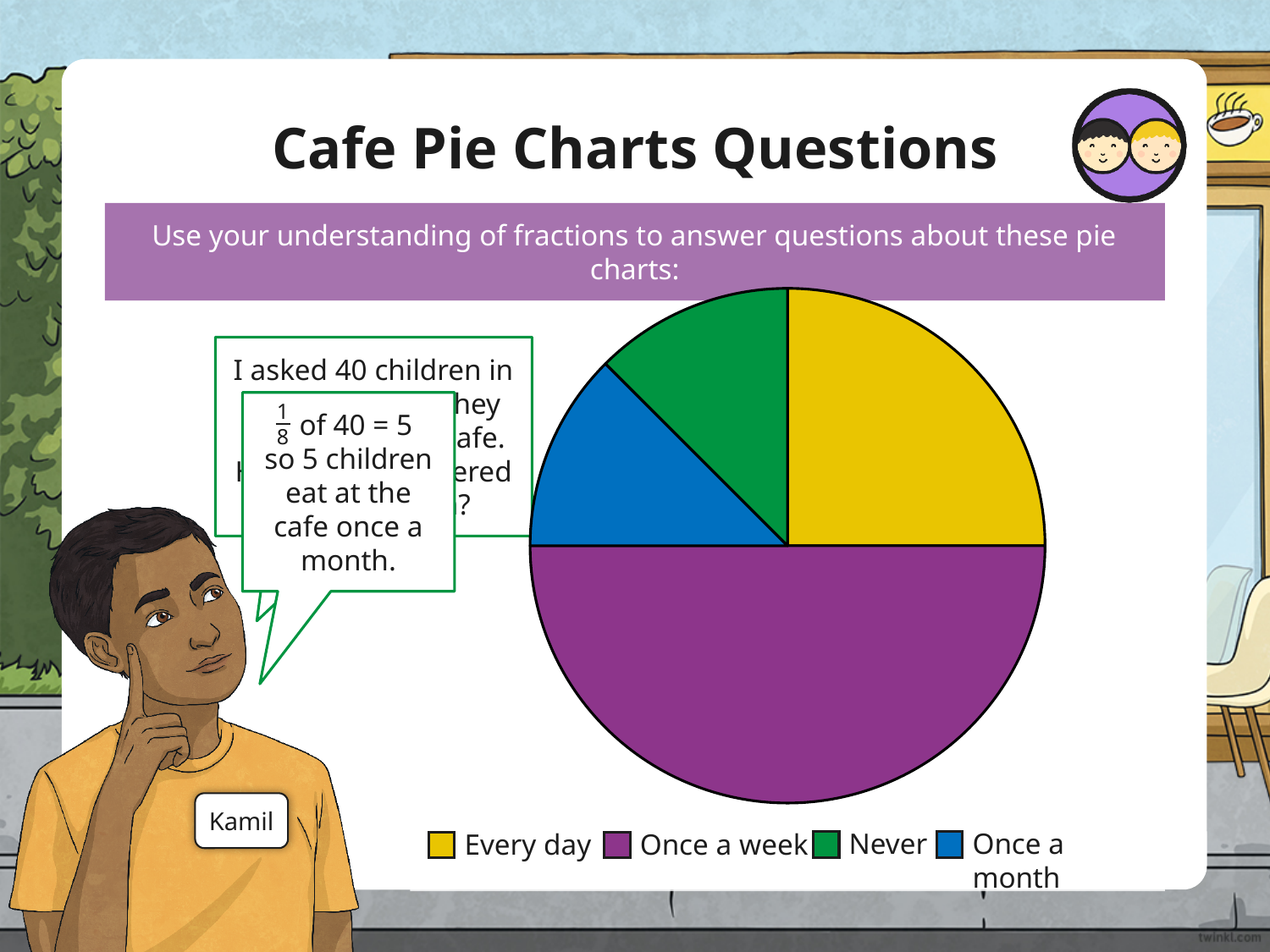
What is the title of the slide? Cafe Pie Charts Questions What fraction of the pie chart does the Once a month slice represent, according to the speech bubble? 1/8 How many slices does the pie chart have? 4 What kind of chart is shown on the slide? pie chart Which category takes up the largest slice of the pie chart? Once a week Which colour represents Never in the pie chart? green Which slice is larger, Every day or Never? Every day Which slice is larger, Once a week or Once a month? Once a week Which slice is larger, Every day or Once a week? Once a week How many children were asked in total, according to the speech bubble? 40 How many entries does the legend of the pie chart list? 4 According to the speech bubble, how many children eat at the cafe once a month? 5